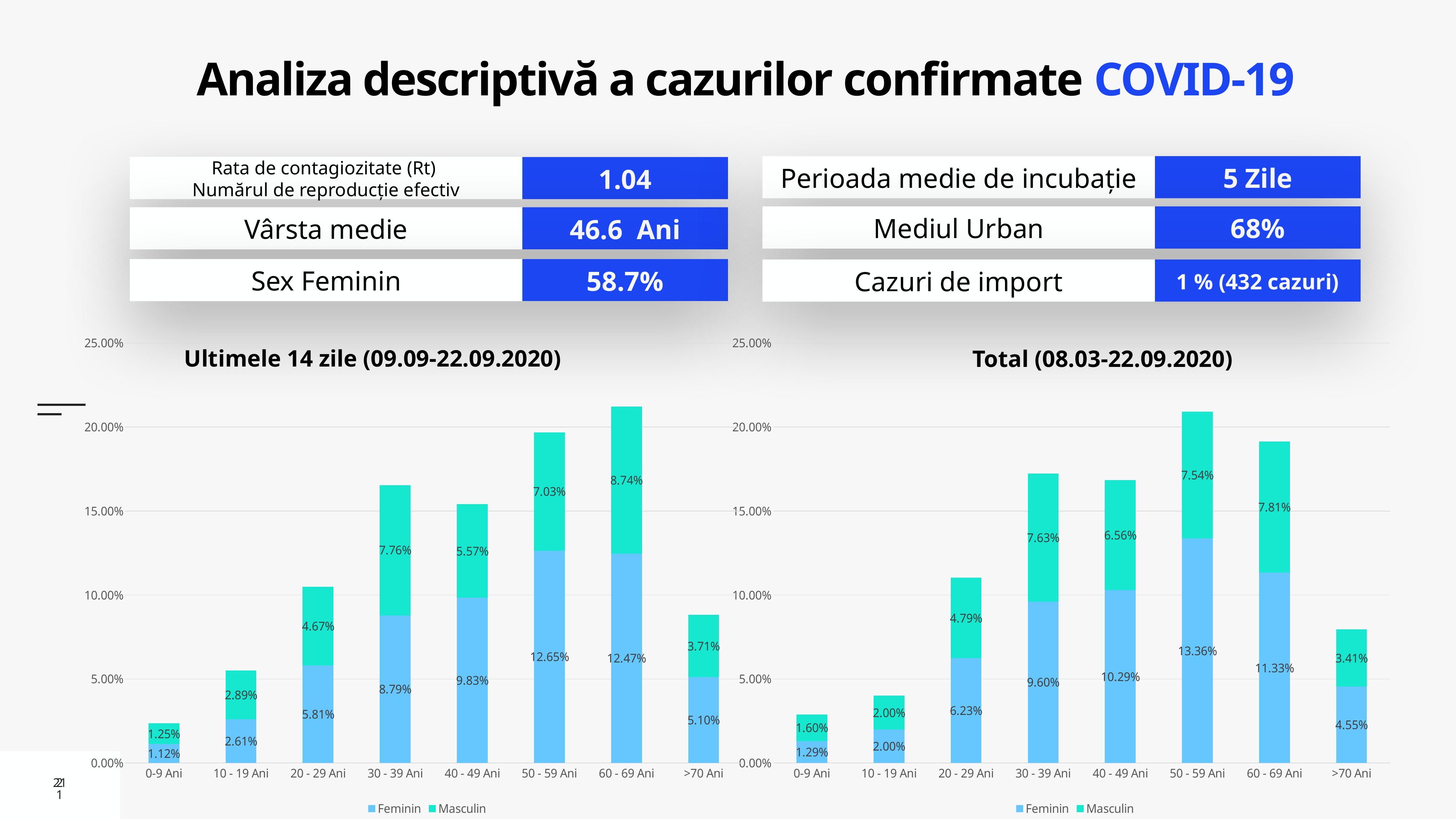
In the 'Ultimele 14 zile (09.09-22.09.2020)' chart, what is the Feminin value for 50 - 59 Ani? 12.65% In the 'Total (08.03-22.09.2020)' chart, is the total stacked bar for 30 - 39 Ani greater or less than 15.00%? greater In the 'Ultimele 14 zile (09.09-22.09.2020)' chart, what is the total stacked value for 60 - 69 Ani? 21.21% In the 'Ultimele 14 zile (09.09-22.09.2020)' chart, which age group has the highest Masculin value? 60 - 69 Ani How many age groups are shown on the x axis of the 'Total (08.03-22.09.2020)' chart? 8 In the 'Total (08.03-22.09.2020)' chart, what is the Masculin value for 60 - 69 Ani? 7.81% In the 'Total (08.03-22.09.2020)' chart, what is the total stacked value for 50 - 59 Ani? 20.90% In the 'Total (08.03-22.09.2020)' chart, which age group has the lowest Feminin value? 0-9 Ani In the 'Ultimele 14 zile (09.09-22.09.2020)' chart, which is larger for 30 - 39 Ani: the Feminin value or the Masculin value? Feminin In the 'Total (08.03-22.09.2020)' chart, what is the difference between the Feminin and Masculin values for 50 - 59 Ani? 5.82% How many series does the legend of the 'Ultimele 14 zile (09.09-22.09.2020)' chart list? 2 What kind of chart is the 'Total (08.03-22.09.2020)' chart? Stacked bar chart